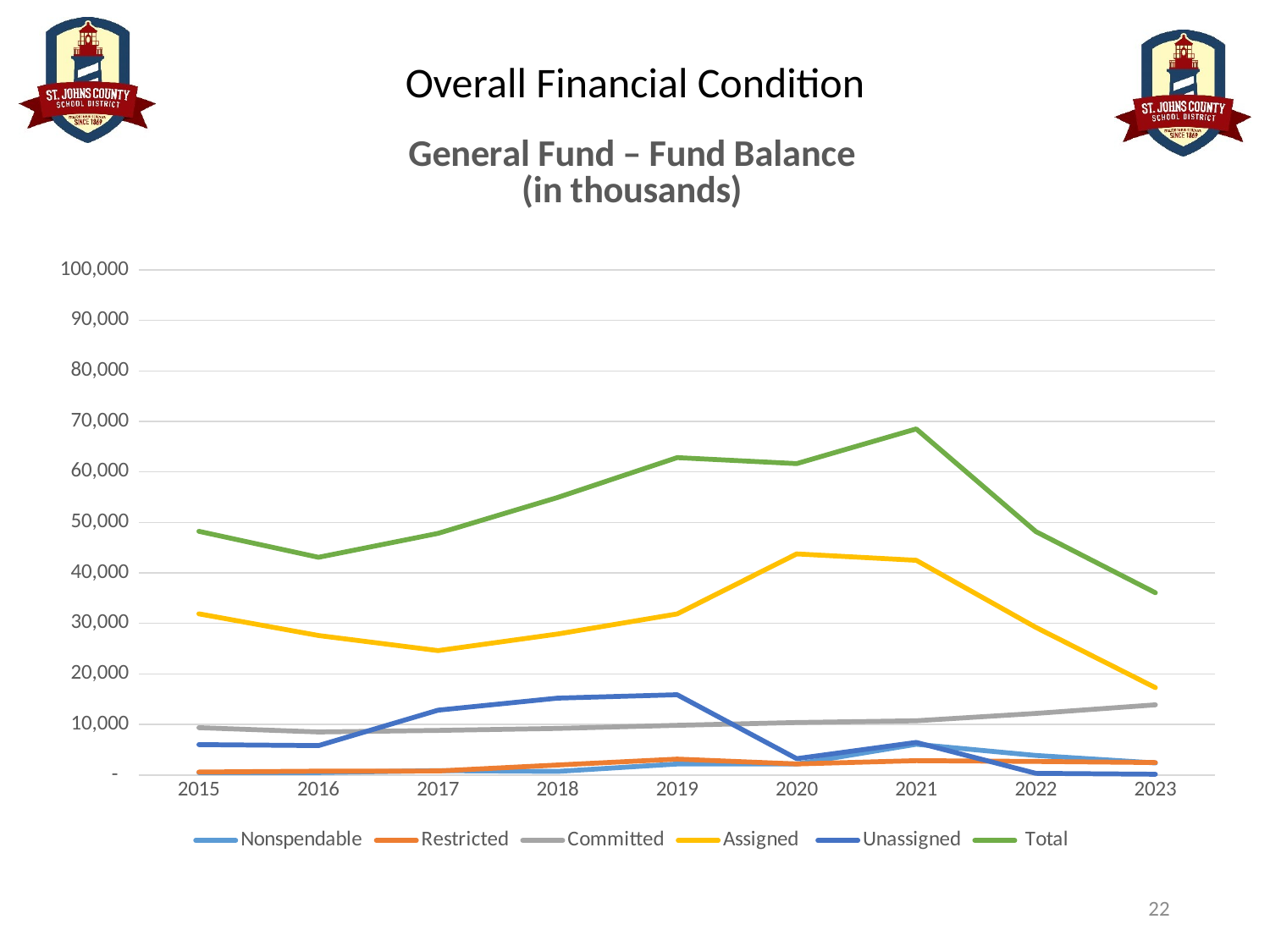
Is the Total value for 2023 greater or less than 40,000? less In which year is the Total line at its highest? 2021 In which year is the Total line at its lowest? 2023 Does the Total line rise or fall from 2021 to 2023? Falls How many years are shown on the x axis? 9 Is the Assigned value for 2020 greater or less than 40,000? greater What is the title of the chart? General Fund – Fund Balance (in thousands) What kind of chart is shown on the slide? Line chart Which is larger, the Assigned value for 2020 or the Assigned value for 2017? 2020 Is the Total value for 2021 greater or less than 60,000? greater How many series does the legend list? 6